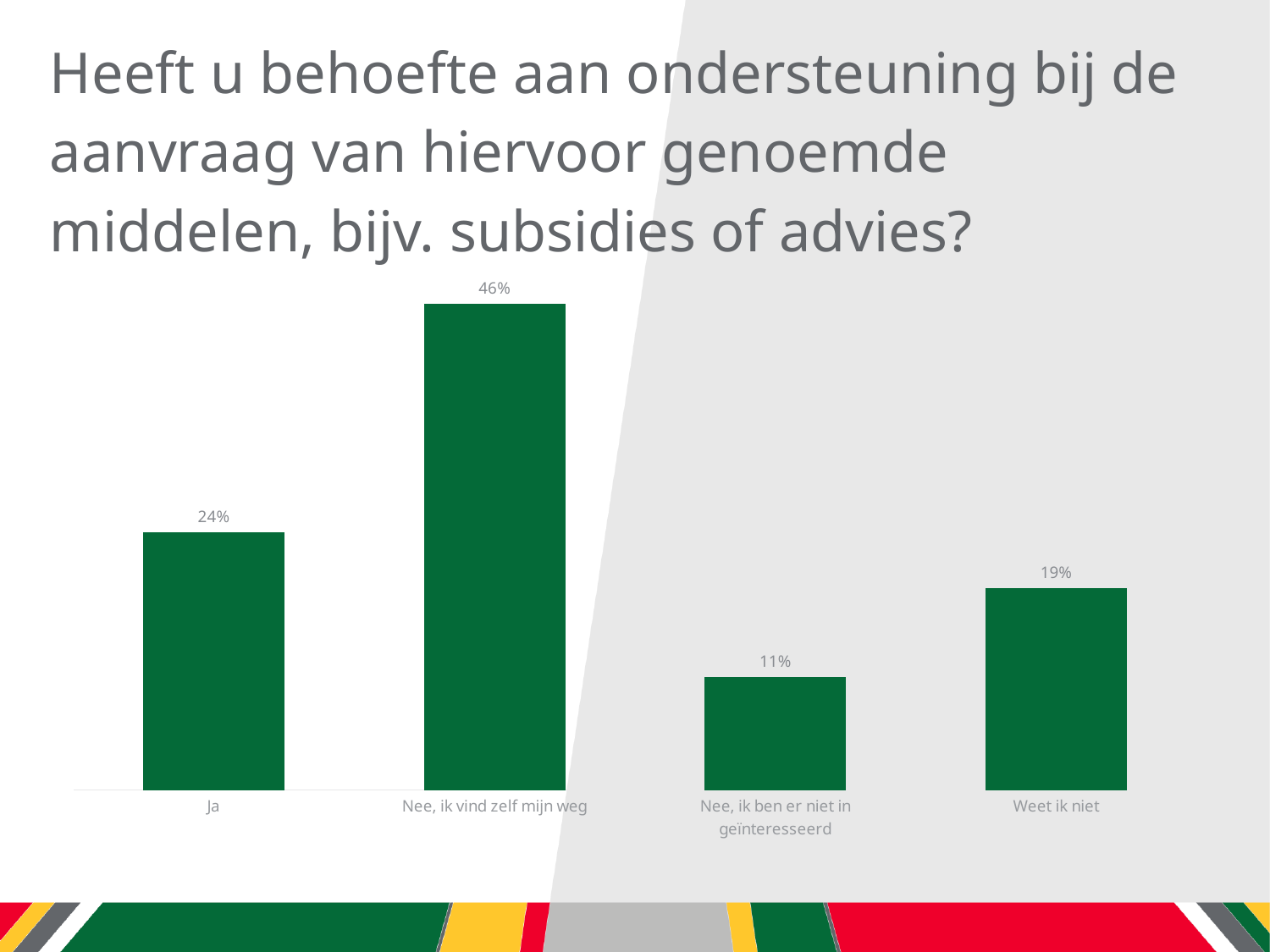
What colour are the bars in the chart? Green What is the value for "Nee, ik ben er niet in geïnteresseerd"? 11% Which category has the lowest value? Nee, ik ben er niet in geïnteresseerd What is the difference between the values for "Weet ik niet" and "Nee, ik ben er niet in geïnteresseerd"? 8% Which category has the highest value? Nee, ik vind zelf mijn weg Which is larger, the value for "Ja" or the value for "Weet ik niet"? Ja What is the difference between the values for "Nee, ik vind zelf mijn weg" and "Ja"? 22% What kind of chart is shown on the slide? Bar chart What is the value for "Weet ik niet"? 19% What is the value for "Ja"? 24% How many categories are shown in the chart? 4 What is the value for "Nee, ik vind zelf mijn weg"? 46%